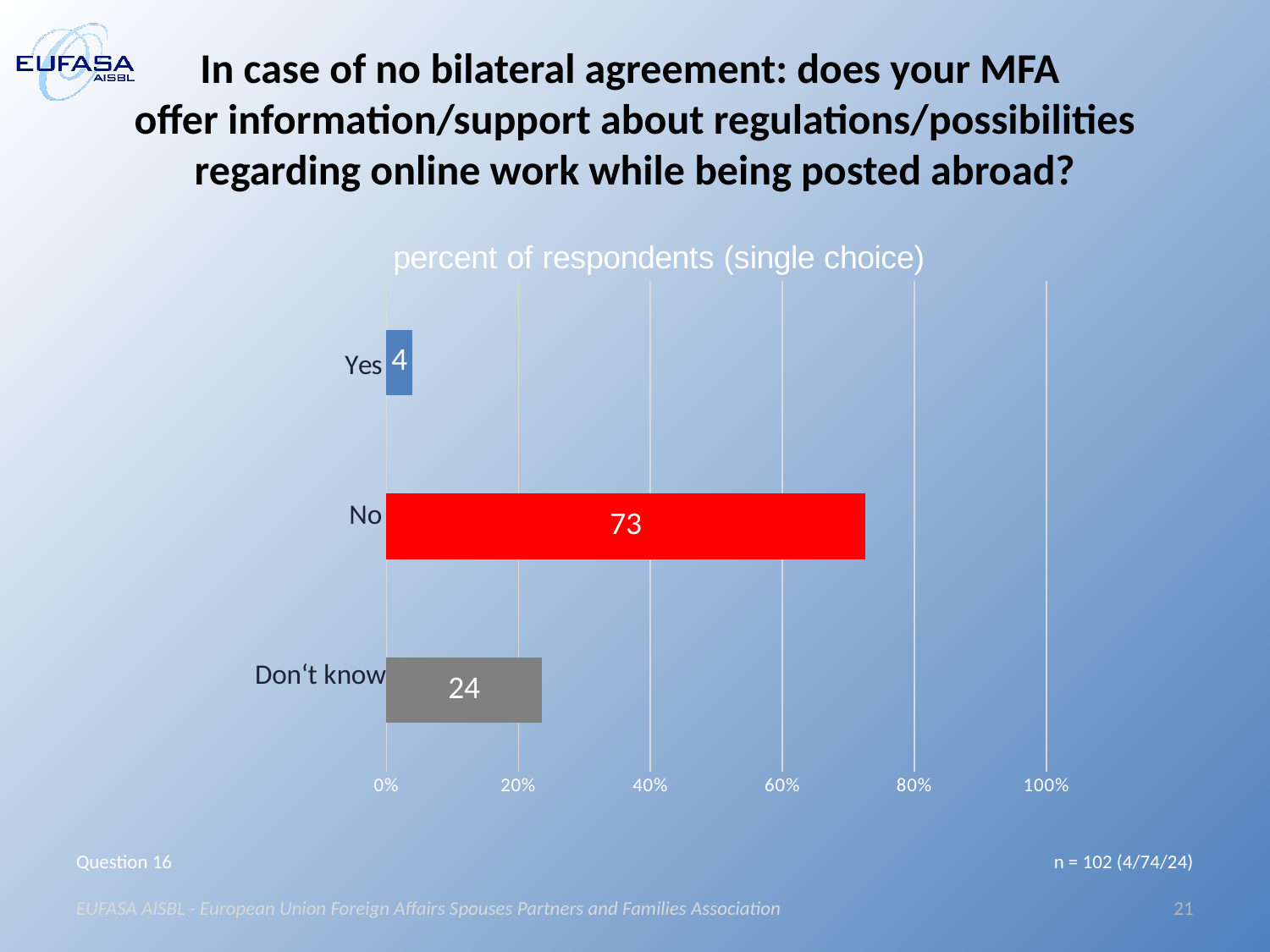
Which category has the highest value? No Is the value for "No" greater or less than 60%? greater What is the value for "No"? 73 What is the difference between the values for "No" and "Don't know"? 49 What is the value for "Yes"? 4 What is the title of the chart? percent of respondents (single choice) What kind of chart is shown on the slide? bar chart What is the difference between the values for "Don't know" and "Yes"? 20 What is the value for "Don't know"? 24 How many categories are shown in the chart? 3 Which is larger, the value for "Don't know" or the value for "Yes"? Don't know Which category has the lowest value? Yes